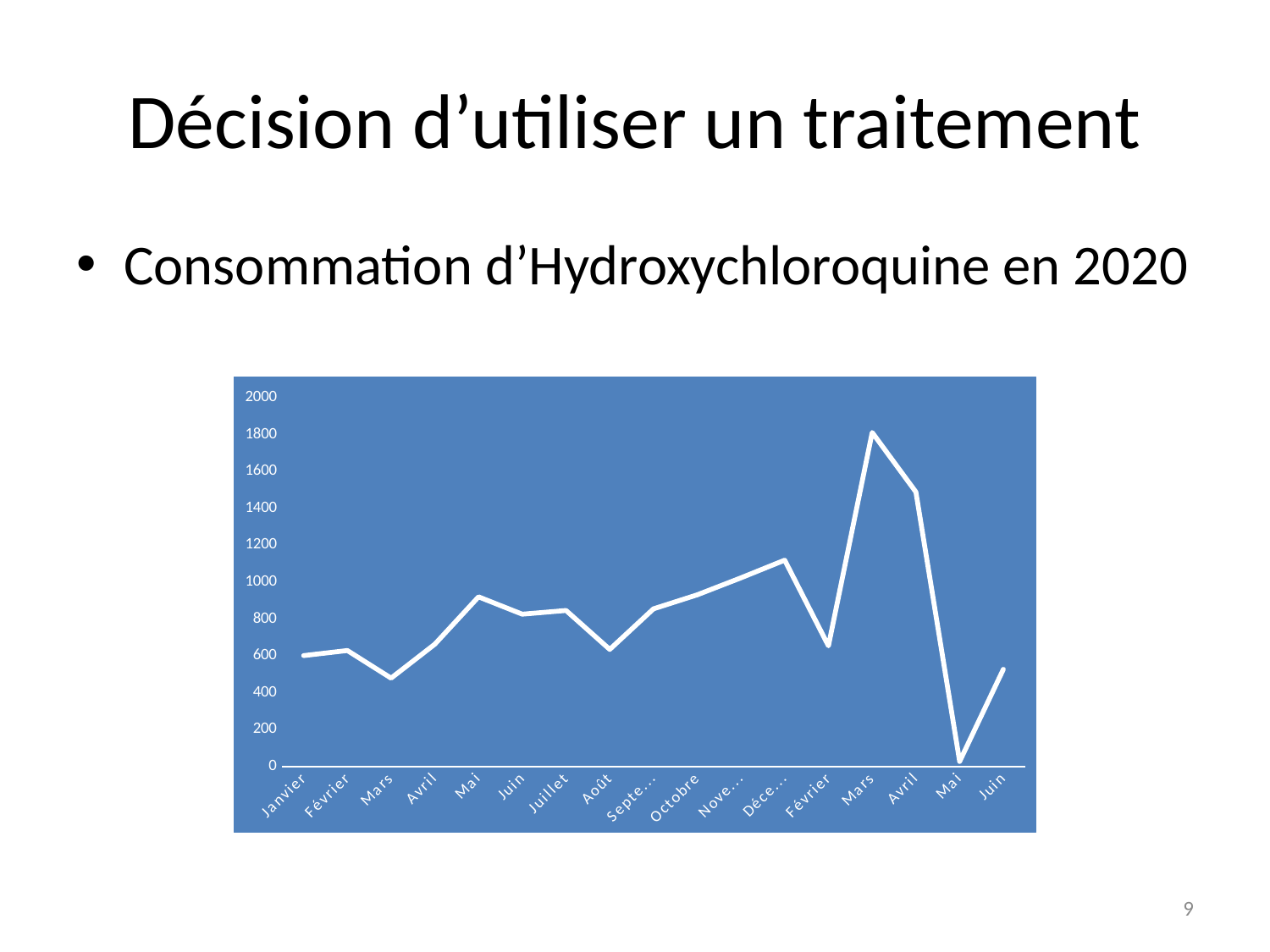
Is the value for the second Mai greater or less than 200? less What kind of chart is shown on the slide? line chart Is the value for Décembre greater or less than 1000? greater What is the highest value shown on the y axis of the chart? 2000 Is the value for Août greater or less than 800? less Which month has the highest value on the chart? Mars (the second Mars) Which month has the lowest value on the chart? Mai (the second Mai) Which is larger, the value for the first Mai or the value for the first Mars? Mai How many data points are plotted along the x axis of the chart? 17 Do the values rise or fall from Août to Décembre? rise